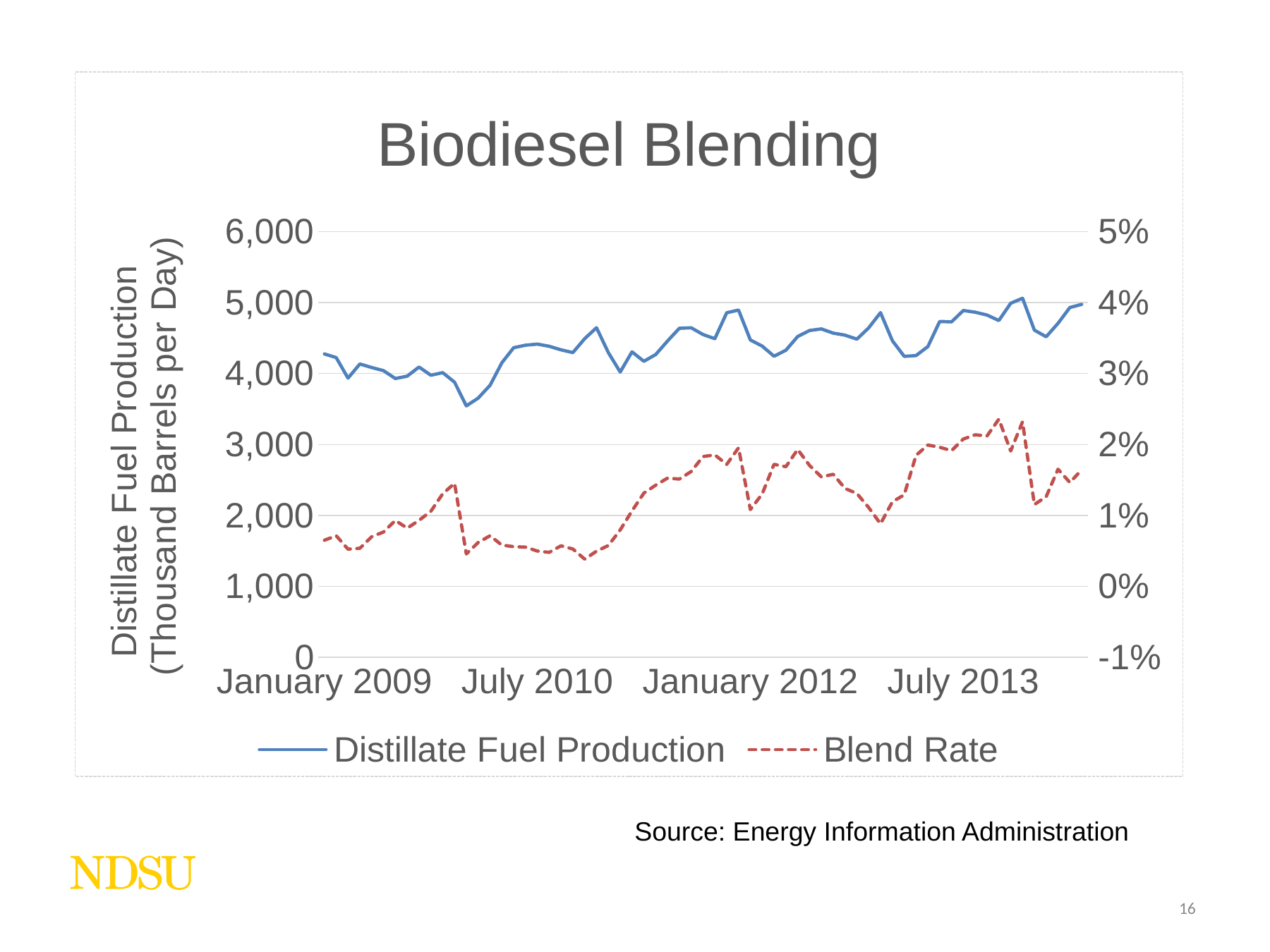
Which series is drawn with a dashed line? Blend Rate What is the title of the chart? Biodiesel Blending What kind of chart is shown on the slide? Line chart Is the value for Distillate Fuel Production at January 2009 greater or less than 4,000? greater Does Distillate Fuel Production generally rise or fall from January 2009 to the end of the chart? rise Is the Blend Rate at July 2010 greater or less than 1%? less Is the highest Blend Rate shown on the chart greater or less than 3%? less How many series does the legend list? 2 Does the Blend Rate generally rise or fall from January 2009 to the end of the chart? rise